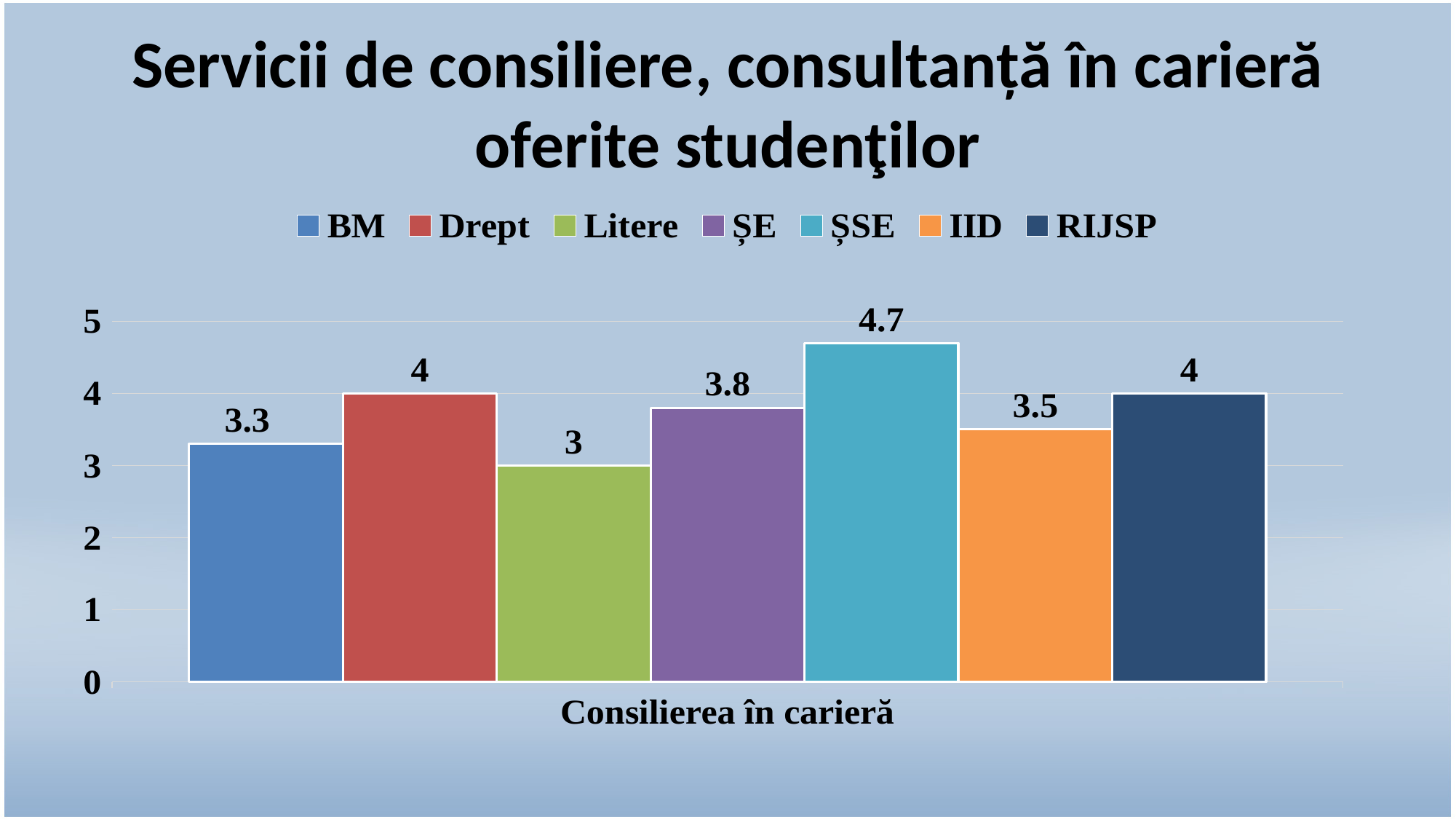
How many series does the legend list? 7 What is the value for ȘSE? 4.7 Is the value for ȘE greater or less than 4? less What is the difference between the values for ȘE and BM? 0.5 Which series has the highest value? ȘSE What is the label on the x axis of the chart? Consilierea în carieră What is the difference between the values for ȘSE and Litere? 1.7 What is the value for IID? 3.5 Which is larger, the value for Drept or the value for IID? Drept What is the value for BM? 3.3 What kind of chart is shown on the slide? bar chart Which series has the lowest value? Litere